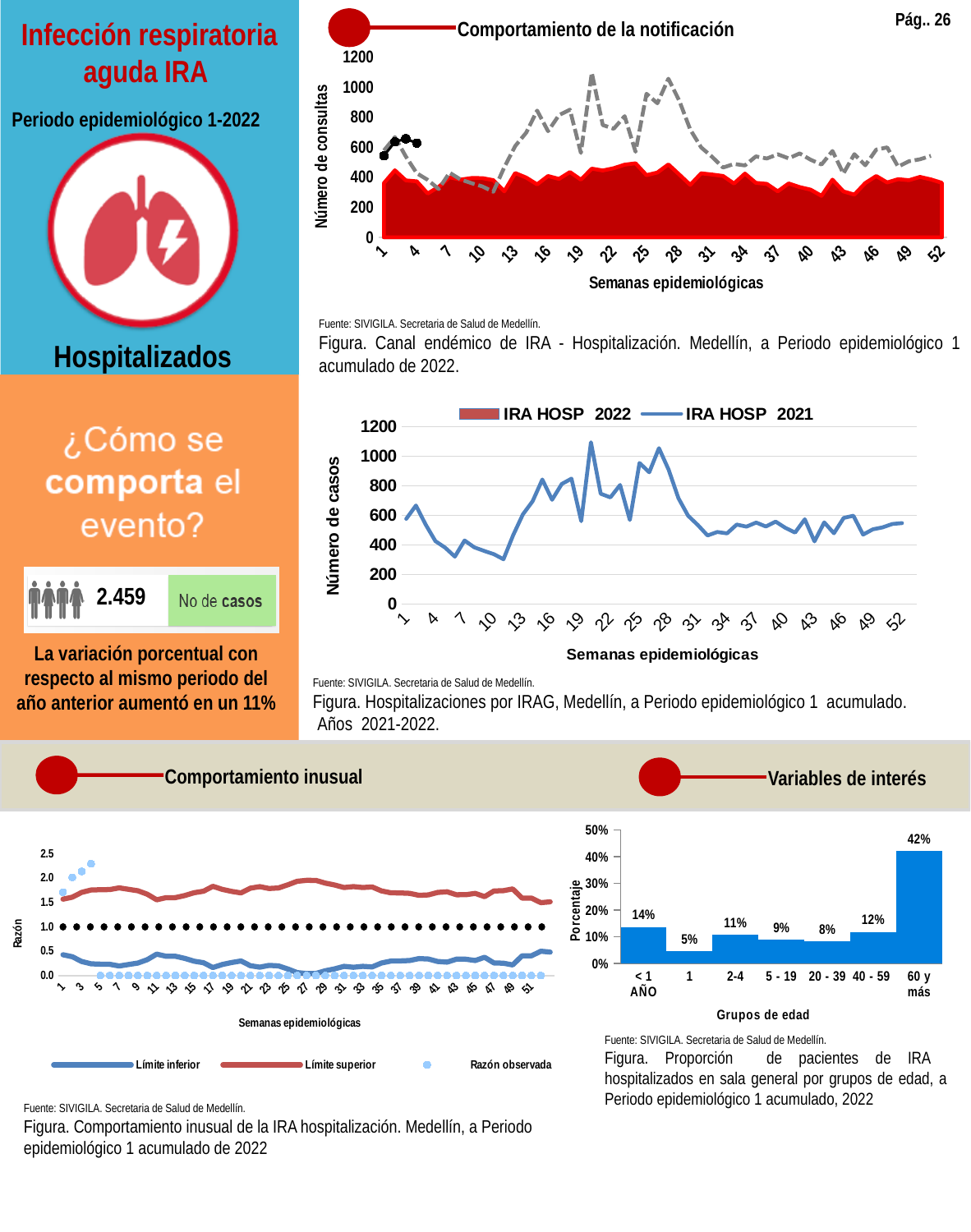
In the bar chart by age group (bottom right), which has a larger percentage: '2-4' or '40 - 59'? 40 - 59 How many series does the legend list in the chart 'Comportamiento inusual de la IRA hospitalización' (bottom left)? 3 In the bar chart by age group (bottom right), which age group has the highest percentage? 60 y más In the bar chart by age group (bottom right), what is the percentage for the '< 1 AÑO' group? 14% How many series does the legend list in the chart 'Hospitalizaciones por IRAG, Medellín' (middle right)? 2 In the chart 'Canal endémico de IRA - Hospitalización' (top right), what is the label of the x axis? Semanas epidemiológicas In the chart 'Hospitalizaciones por IRAG' (middle right), is the peak value of the IRA HOSP 2021 line greater or less than 1000? greater What kind of chart is the 'Grupos de edad' chart at the bottom right? Bar chart In the bar chart 'Proporción de pacientes de IRA hospitalizados en sala general por grupos de edad', what is the percentage for the '60 y más' age group? 42% How many age groups are shown in the bar chart at the bottom right? 7 In the bar chart by age group (bottom right), what is the difference between the '60 y más' group and the '< 1 AÑO' group? 28 percentage points In the bar chart by age group (bottom right), which age group has the lowest percentage? 1